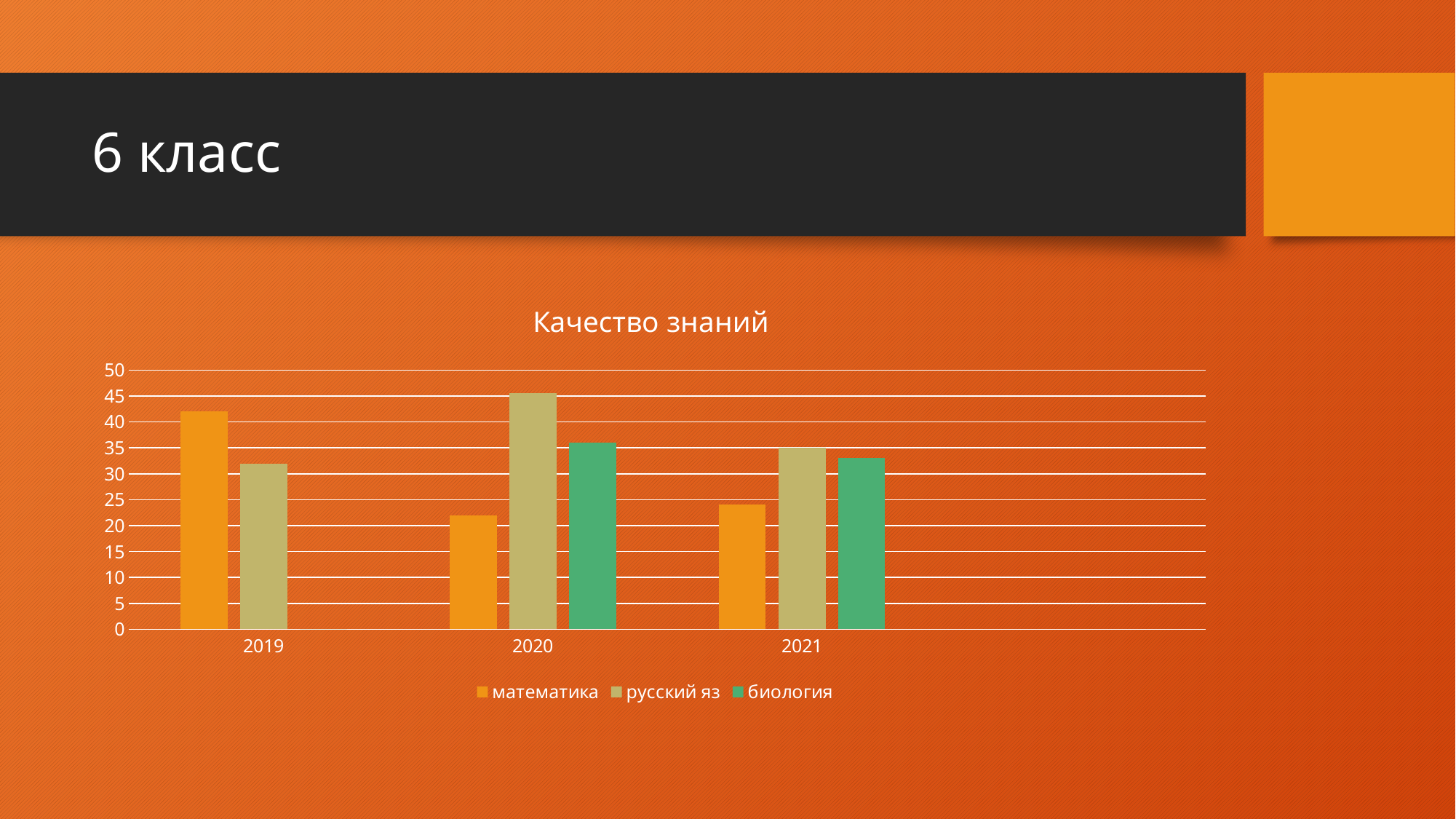
Which year has no bar for биология? 2019 Which series has the highest bar in the whole chart? русский яз Is the value for математика in 2019 greater or less than 40? greater How many years are shown on the x axis? 3 What is the title of the chart? Качество знаний Is the value for русский яз in 2020 greater or less than 40? greater In 2019, which is larger: математика or русский яз? математика In 2020, which is larger: русский яз or биология? русский яз How many series does the legend list? 3 Does the value for математика rise or fall from 2019 to 2020? fall What kind of chart is shown on the slide? bar chart Is the value for математика in 2020 greater or less than 25? less